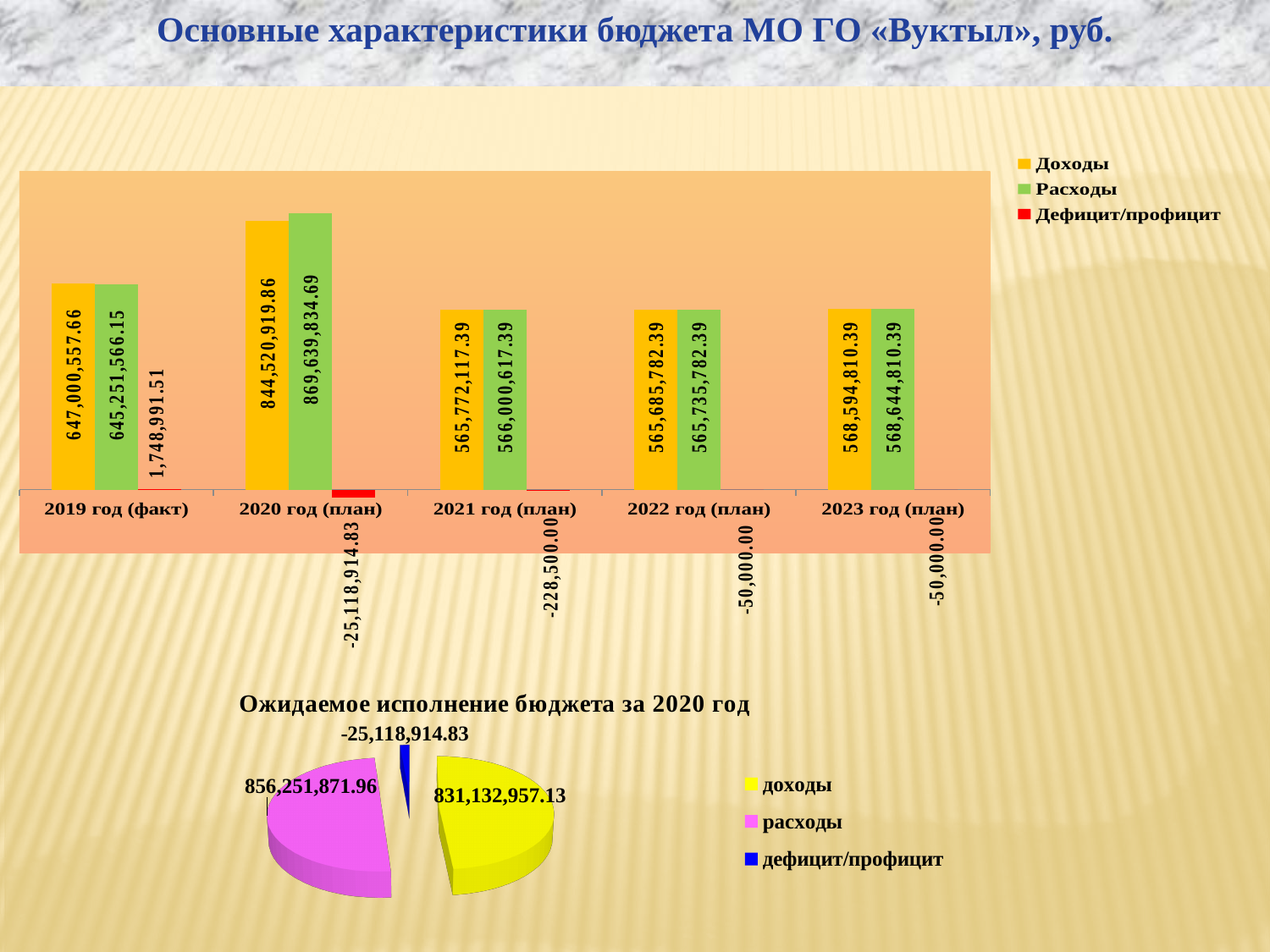
In the bar chart, what is the value of Доходы for 2023 год (план)? 568,594,810.39 How many series does the legend of the bar chart list? 3 In the bar chart, what is the value of Расходы for 2020 год (план)? 869,639,834.69 In the bar chart, which year has the highest Расходы? 2020 год (план) In the pie chart 'Ожидаемое исполнение бюджета за 2020 год', what is the value of расходы? 856,251,871.96 In the bar chart, what is the difference between Доходы and Расходы for 2019 год (факт)? 1,748,991.51 In the bar chart, what is the value of Дефицит/профицит for 2021 год (план)? -228,500.00 In the bar chart, which year has the highest Доходы? 2020 год (план) In the bar chart, which is larger for 2020 год (план): Доходы or Расходы? Расходы How many year categories does the bar chart show? 5 In the bar chart, what is the value of Доходы for 2019 год (факт)? 647,000,557.66 What type of chart is the chart titled 'Ожидаемое исполнение бюджета за 2020 год'? Pie chart